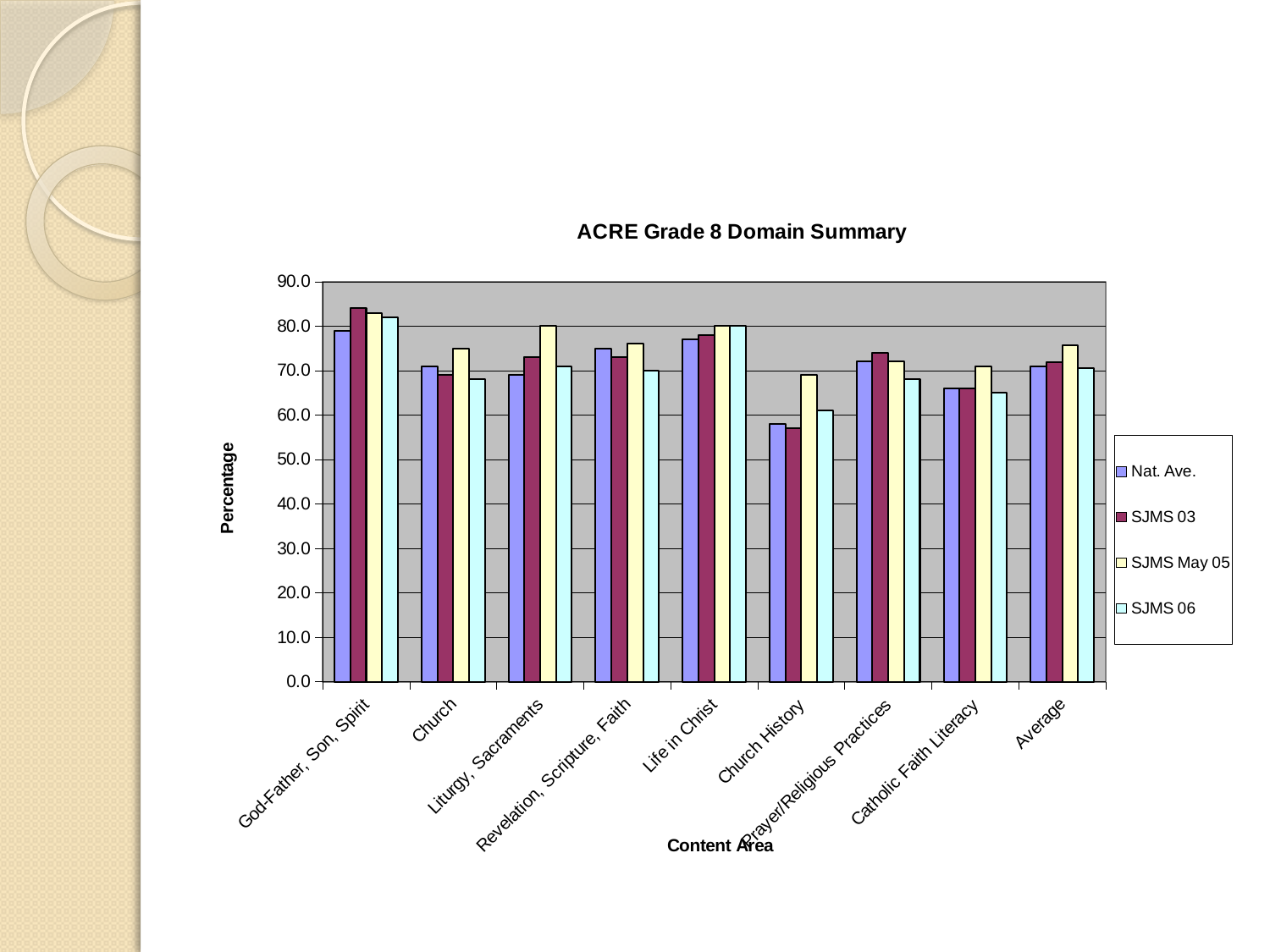
Is the SJMS 06 value for Catholic Faith Literacy greater or less than 70.0? less What is the title of the chart? ACRE Grade 8 Domain Summary What kind of chart is shown on the slide? Bar chart How many series does the legend list? 4 How many content area categories are shown on the x axis? 9 Is the Nat. Ave. value for Church History greater or less than 60.0? less For Liturgy, Sacraments, which is larger: the Nat. Ave. value or the SJMS May 05 value? SJMS May 05 Which content area has the lowest Nat. Ave. value? Church History Which content area has the highest SJMS 03 value? God-Father, Son, Spirit For Church, which is larger: the SJMS May 05 value or the SJMS 06 value? SJMS May 05 Is the SJMS 03 value for God-Father, Son, Spirit greater or less than 80.0? greater What is the label of the vertical axis? Percentage